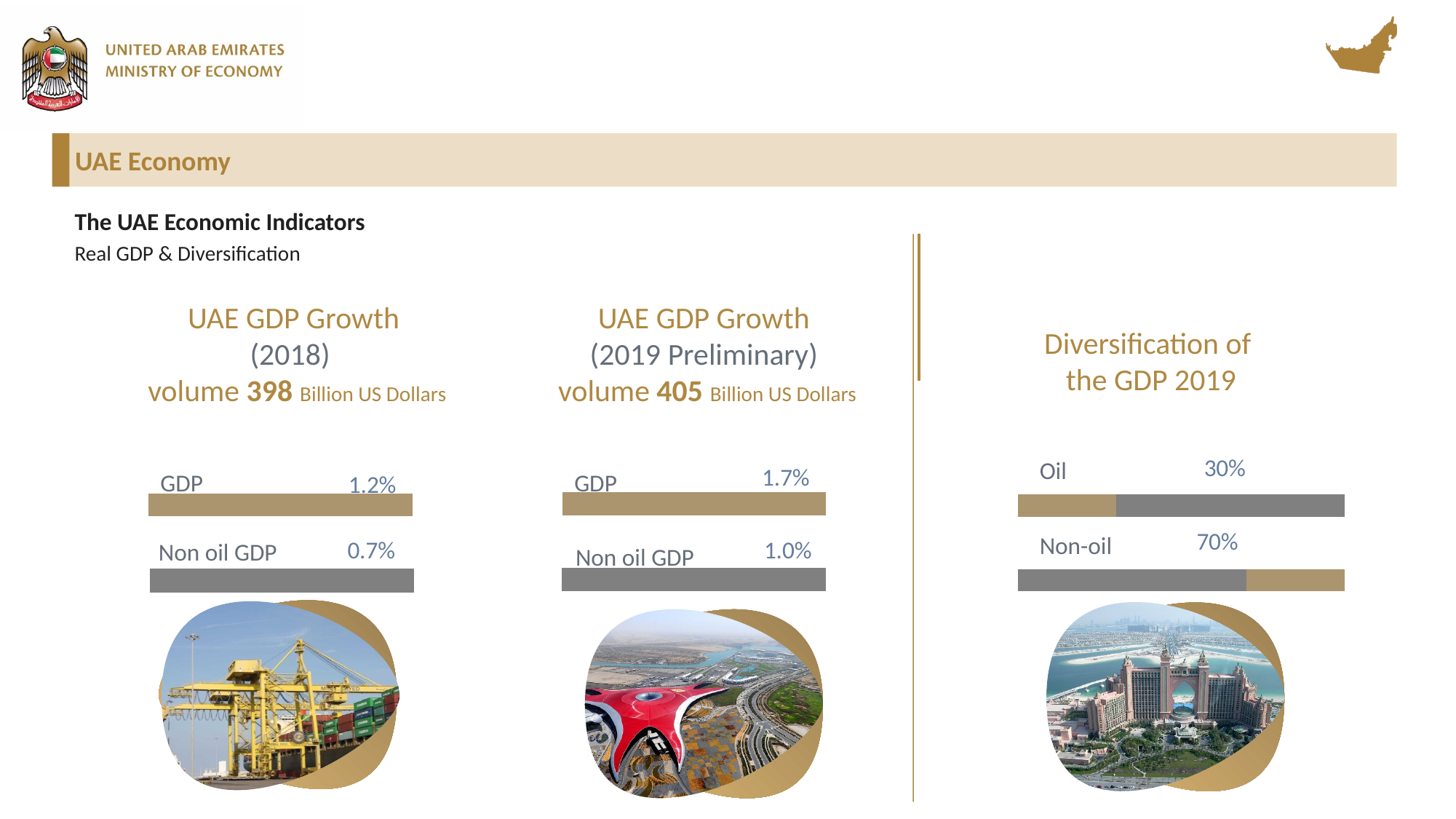
In the Diversification of the GDP 2019 chart, what share is Non-oil? 70% In the UAE GDP Growth (2018) chart, what is the value for Non oil GDP? 0.7% How many categories are shown in the Diversification of the GDP 2019 chart? 2 In the Diversification of the GDP 2019 chart, what share is Oil? 30% In the UAE GDP Growth (2018) chart, what is the value for GDP? 1.2% In the UAE GDP Growth (2018) chart, what is the difference between GDP and Non oil GDP growth? 0.5% In the Diversification of the GDP 2019 chart, which category is the largest? Non-oil In the Diversification of the GDP 2019 chart, what is the difference between the Non-oil and Oil shares? 40% In the UAE GDP Growth (2019 Preliminary) chart, which is larger, GDP or Non oil GDP? GDP In the UAE GDP Growth (2019 Preliminary) chart, what is the value for Non oil GDP? 1.0% In the UAE GDP Growth (2019 Preliminary) chart, what is the value for GDP? 1.7% What kind of chart is used in the UAE GDP Growth (2018) panel? Bar chart